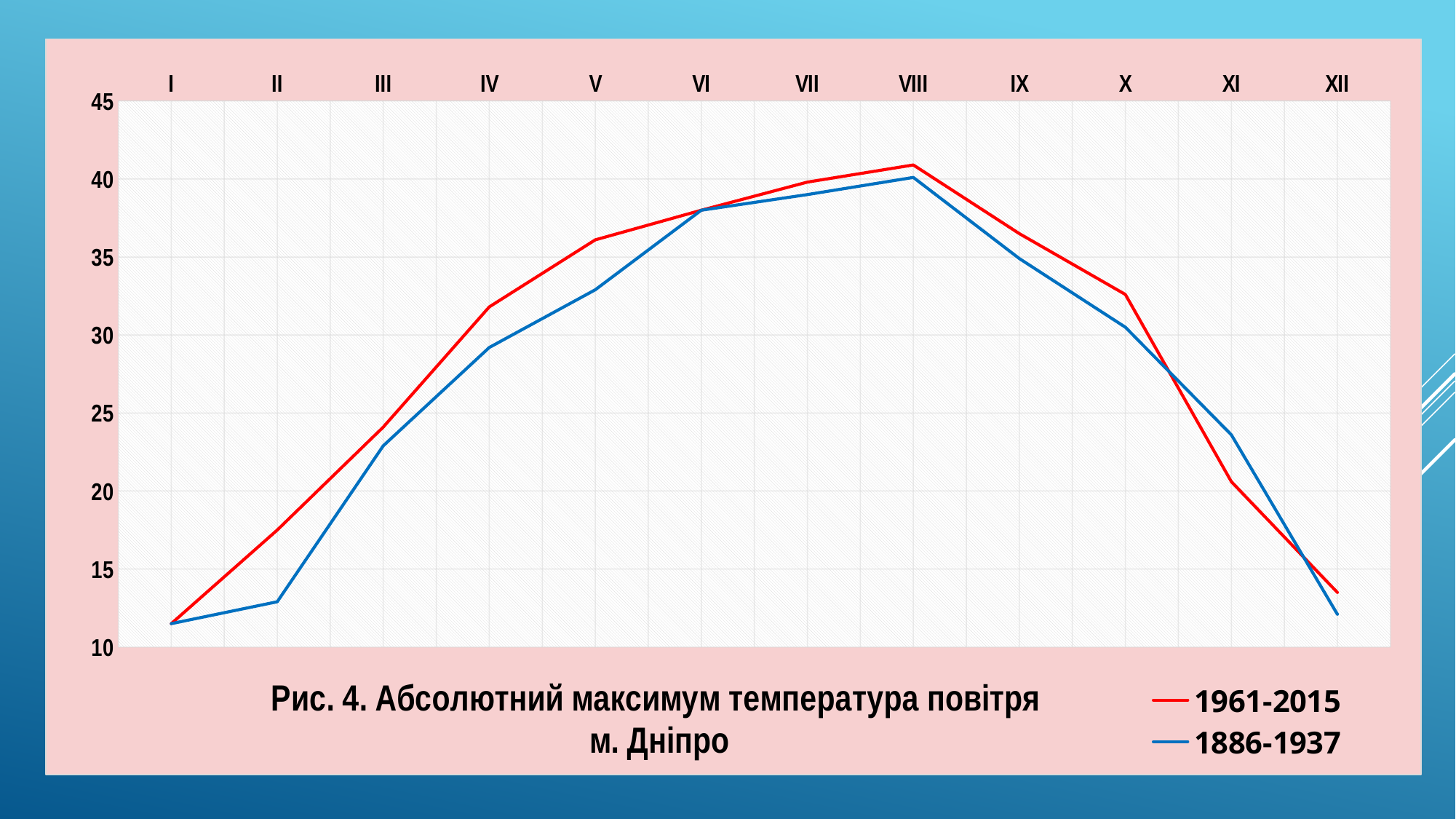
Is the value for the 1886-1937 series in month II greater or less than 15? less Is the value for the 1961-2015 series in month IV greater or less than 30? greater What kind of chart is shown on the slide? line chart How many series does the legend list? 2 In which month does the 1886-1937 series reach its highest value? VIII In month XI, which series has the higher value, 1961-2015 or 1886-1937? 1886-1937 How many months (categories) are plotted along the x axis? 12 In which month is the 1961-2015 series at its lowest value? I Do the values of the 1961-2015 series rise or fall from month VIII to month XII? fall In month IV, which series has the higher value, 1961-2015 or 1886-1937? 1961-2015 In which month does the 1961-2015 series reach its highest value? VIII Is the value for the 1961-2015 series in month XI greater or less than 25? less